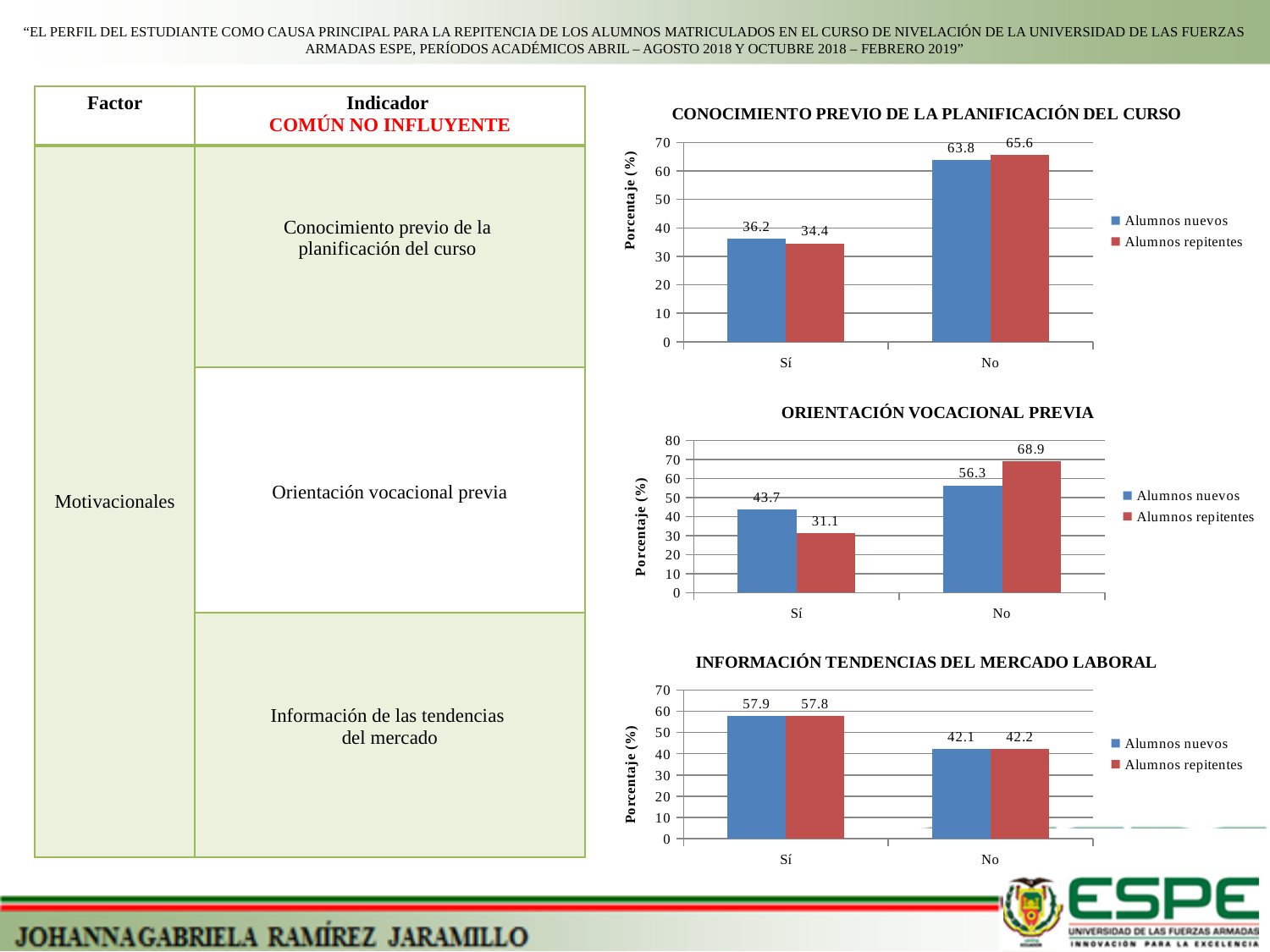
In the chart titled "CONOCIMIENTO PREVIO DE LA PLANIFICACIÓN DEL CURSO", what is the value for Alumnos repitentes in the No category? 65.6 In the chart titled "ORIENTACIÓN VOCACIONAL PREVIA", which bar has the highest value? Alumnos repitentes, No (68.9) In the chart titled "ORIENTACIÓN VOCACIONAL PREVIA", what is the value for Alumnos repitentes in the Sí category? 31.1 In the chart titled "INFORMACIÓN TENDENCIAS DEL MERCADO LABORAL", what kind of chart is shown? Bar chart In the chart titled "CONOCIMIENTO PREVIO DE LA PLANIFICACIÓN DEL CURSO", what is the difference between Alumnos repitentes and Alumnos nuevos in the No category? 1.8 In the chart titled "INFORMACIÓN TENDENCIAS DEL MERCADO LABORAL", what is the label of the y axis? Porcentaje (%) In the chart titled "CONOCIMIENTO PREVIO DE LA PLANIFICACIÓN DEL CURSO", what is the value for Alumnos nuevos in the Sí category? 36.2 In the chart titled "ORIENTACIÓN VOCACIONAL PREVIA", which is larger in the Sí category: Alumnos nuevos or Alumnos repitentes? Alumnos nuevos In the chart titled "INFORMACIÓN TENDENCIAS DEL MERCADO LABORAL", what is the value for Alumnos nuevos in the No category? 42.1 In the chart titled "ORIENTACIÓN VOCACIONAL PREVIA", what is the difference between Alumnos nuevos and Alumnos repitentes in the Sí category? 12.6 In the chart titled "CONOCIMIENTO PREVIO DE LA PLANIFICACIÓN DEL CURSO", how many series does the legend list? 2 In the chart titled "INFORMACIÓN TENDENCIAS DEL MERCADO LABORAL", which bar has the lowest value? Alumnos nuevos, No (42.1)